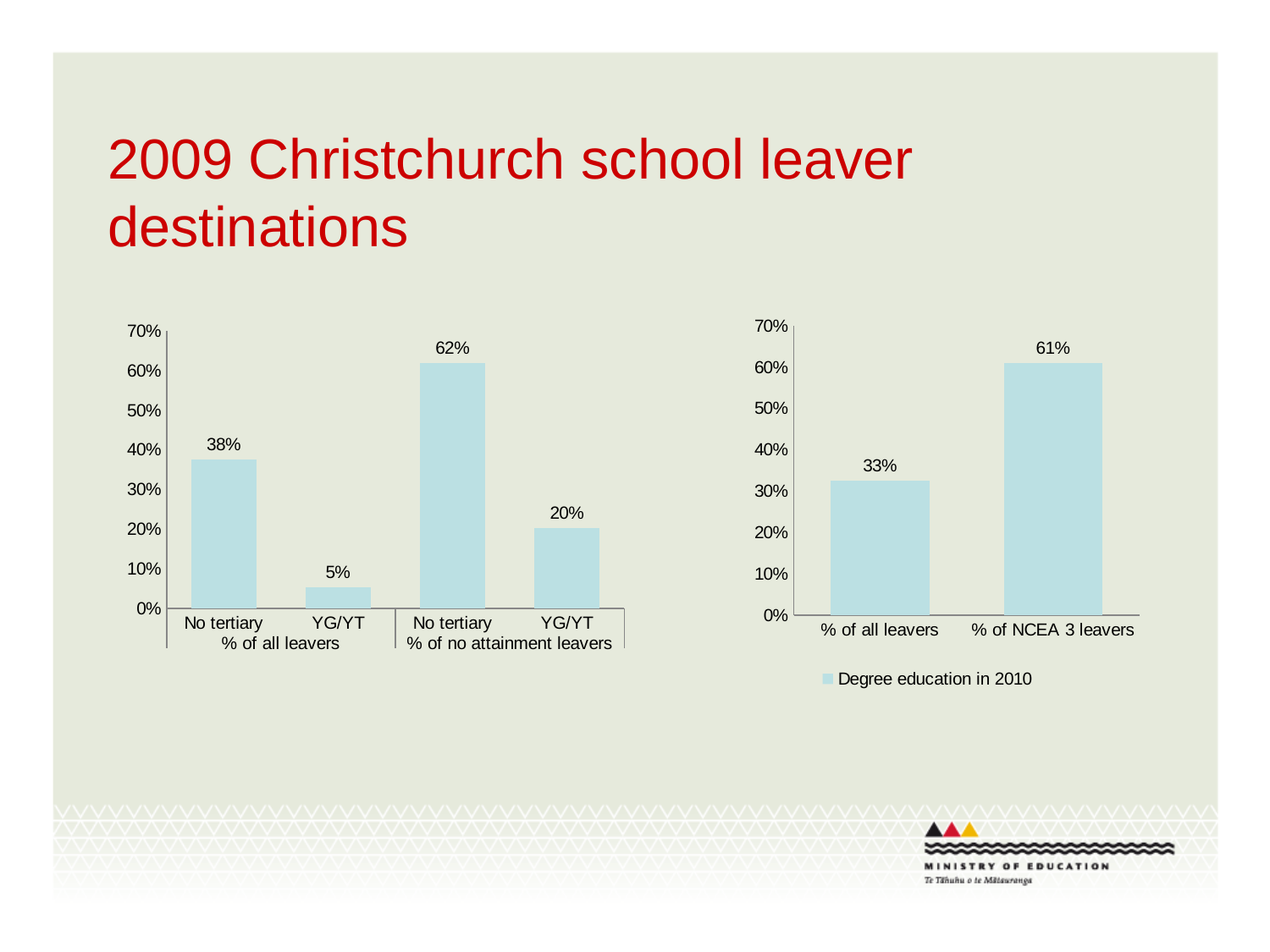
In the left chart, what is the difference between No tertiary for % of no attainment leavers and No tertiary for % of all leavers? 24% In the left chart, which bar has the highest value? No tertiary (% of no attainment leavers) In the right chart, what is the value for % of NCEA 3 leavers? 61% In the right chart, which is larger: % of all leavers or % of NCEA 3 leavers? % of NCEA 3 leavers What kind of chart is the right chart? Bar chart In the left chart, what is the value for YG/YT among % of no attainment leavers? 20% In the right chart, what is the difference between % of NCEA 3 leavers and % of all leavers? 28% What is the legend entry shown under the right chart? Degree education in 2010 In the left chart, which bar has the lowest value? YG/YT (% of all leavers) In the left chart, how many bars are plotted? 4 In the right chart, what is the value for % of all leavers? 33% In the left chart, what is the value for No tertiary among % of all leavers? 38%